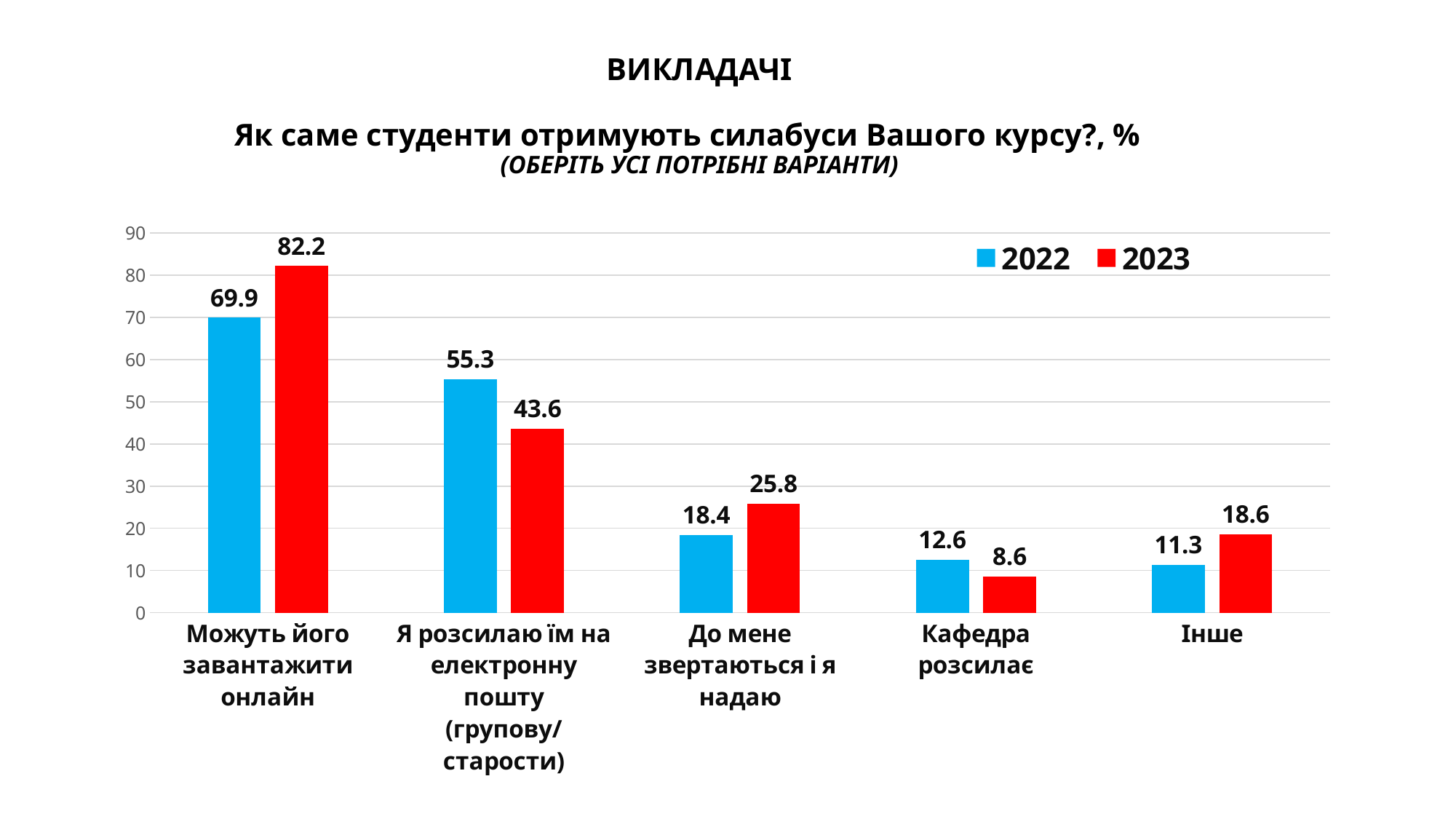
Is the 2023 value for "До мене звертаються і я надаю" greater or less than 20? greater What is the 2022 value for "Я розсилаю їм на електронну пошту (групову/старости)"? 55.3 What is the difference between the 2023 and 2022 values for "Можуть його завантажити онлайн"? 12.3 How many series does the legend list? 2 What is the 2023 value for "Можуть його завантажити онлайн"? 82.2 Which category has the highest 2022 value? Можуть його завантажити онлайн Which is larger for "Я розсилаю їм на електронну пошту (групову/старости)": the 2022 value or the 2023 value? 2022 What kind of chart is shown on the slide? Bar chart How many categories are shown on the x axis? 5 What is the 2023 value for "Кафедра розсилає"? 8.6 Which category has the lowest 2023 value? Кафедра розсилає Which colour represents the 2023 series in the legend? Red